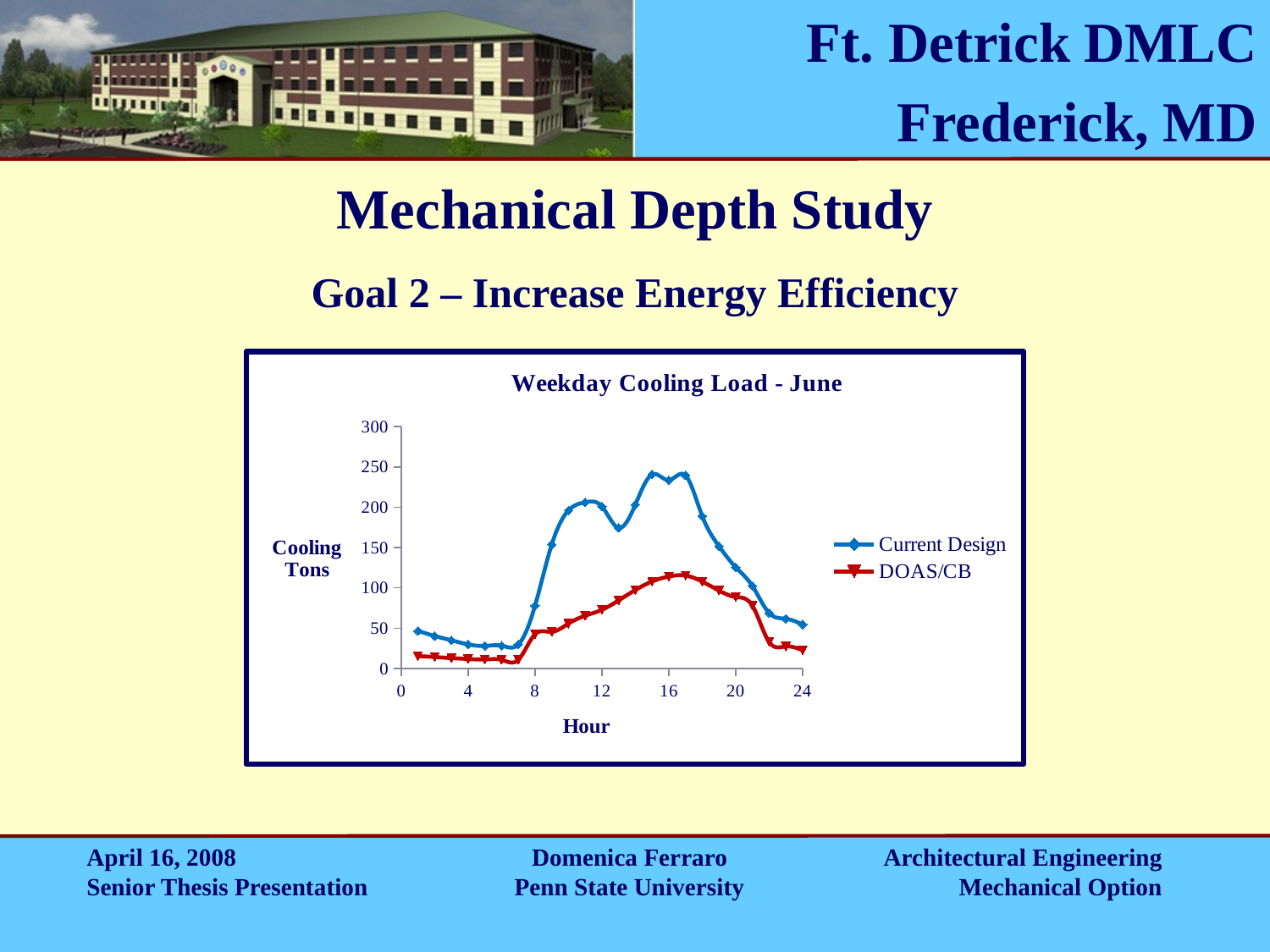
Is the DOAS/CB value at hour 24 greater or less than 50? less At hour 16, which series has the higher cooling load, Current Design or DOAS/CB? Current Design What is the label of the vertical axis? Cooling Tons Does the Current Design cooling load rise or fall between hour 8 and hour 12? rise Is the Current Design value at hour 16 greater or less than 200? greater What kind of chart is shown on the slide? line chart What is the title of the chart? Weekday Cooling Load - June Which series reaches the higher peak cooling load? Current Design Is the DOAS/CB value at hour 16 greater or less than 150? less How many series does the legend list? 2